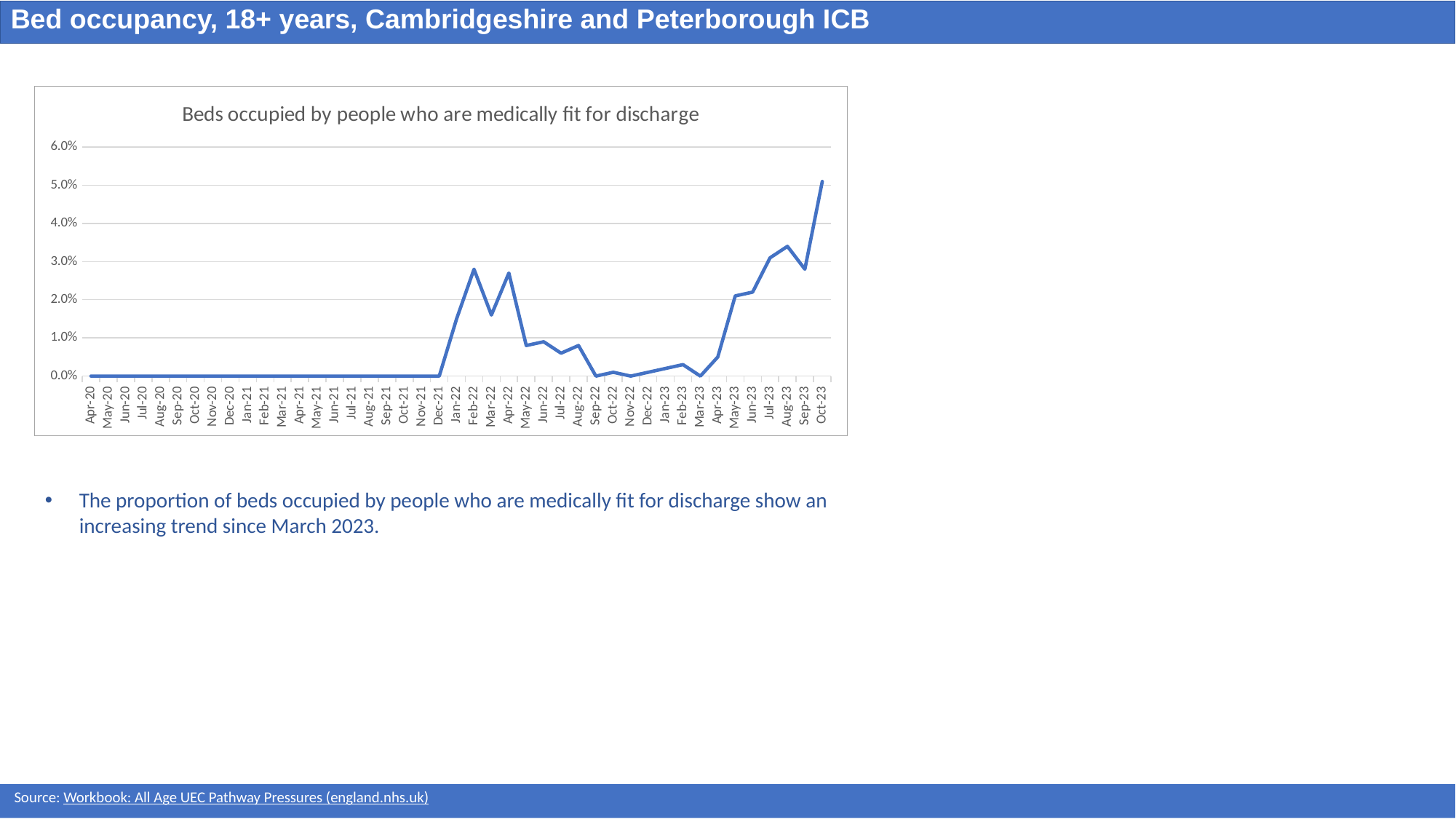
Is the value for Jul-22 greater or less than 1.0%? less Is the value for Feb-22 greater or less than 2.0%? greater What is the value plotted for Jun-21? 0.0% How many monthly data points are plotted on the x axis? 43 What is the title of the chart? Beds occupied by people who are medically fit for discharge Which is larger, the value for Aug-23 or the value for Sep-23? Aug-23 Do the values rise or fall between Mar-23 and Aug-23? Rise Is the value for Oct-23 greater or less than 4.0%? greater What kind of chart is shown on the slide? Line chart Which is larger, the value for Feb-22 or the value for Mar-22? Feb-22 Which month has the highest proportion of beds occupied by people who are medically fit for discharge? Oct-23